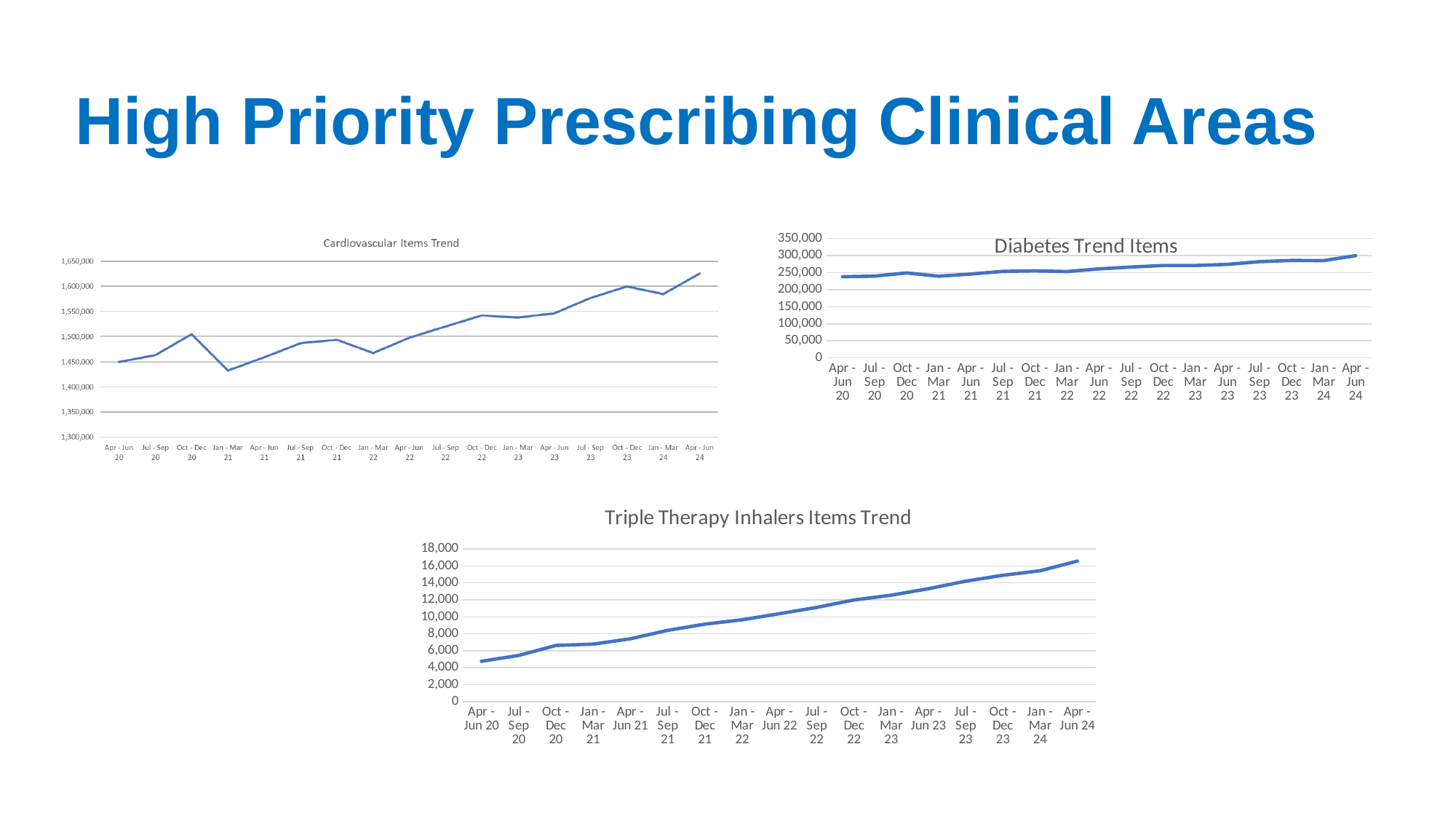
What kind of chart is the Cardiovascular Items Trend chart? line chart On the Cardiovascular Items Trend chart, which quarter has the highest value? Apr - Jun 24 On the Diabetes Trend Items chart, is the value for Apr - Jun 22 greater or less than 200,000? greater On the Triple Therapy Inhalers Items Trend chart, which is larger, the value for Apr - Jun 24 or the value for Apr - Jun 20? Apr - Jun 24 How many charts are shown on the slide? 3 On the Diabetes Trend Items chart, do the values generally rise or fall from Apr - Jun 20 to Apr - Jun 24? rise On the Triple Therapy Inhalers Items Trend chart, is the value for Apr - Jun 20 greater or less than 6,000? less On the Cardiovascular Items Trend chart, is the value for Jan - Mar 21 greater or less than 1,450,000? less How many quarterly points are plotted on the Triple Therapy Inhalers Items Trend chart? 17 On the Diabetes Trend Items chart, which quarter has the highest value? Apr - Jun 24 On the Cardiovascular Items Trend chart, which quarter has the lowest value? Jan - Mar 21